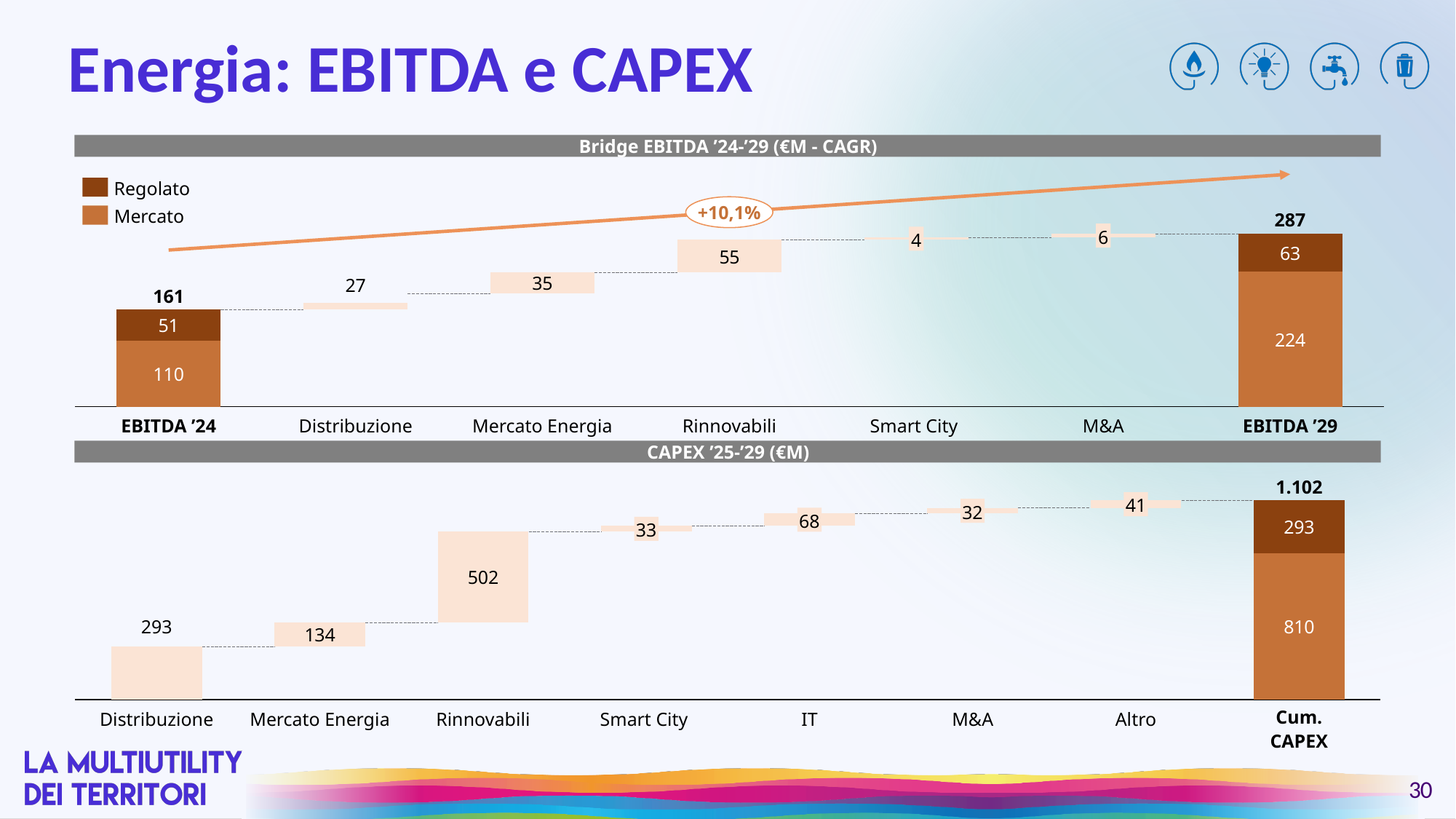
In the CAPEX '25-'29 chart, what is the total Cum. CAPEX? 1.102 In the Bridge EBITDA '24-'29 chart, what is the difference between the Mercato portions of EBITDA '29 and EBITDA '24? 114 In the CAPEX '25-'29 chart, what is the value for Rinnovabili? 502 In the CAPEX '25-'29 chart, how many categories are shown on the x axis? 8 In the Bridge EBITDA '24-'29 chart, what is the Regolato portion of EBITDA '29? 63 In the Bridge EBITDA '24-'29 chart, how many series does the legend list? 2 In the CAPEX '25-'29 chart, which category has the highest value among the bridge steps? Rinnovabili In the Bridge EBITDA '24-'29 chart, what is the contribution of Rinnovabili? 55 In the Bridge EBITDA '24-'29 chart, which bridge step between EBITDA '24 and EBITDA '29 has the smallest value? Smart City In the Bridge EBITDA '24-'29 chart, what is the total EBITDA '24 value? 161 In the CAPEX '25-'29 chart, is the value for IT larger or smaller than the value for M&A? larger In the Bridge EBITDA '24-'29 chart, what CAGR is shown on the arrow? +10,1%